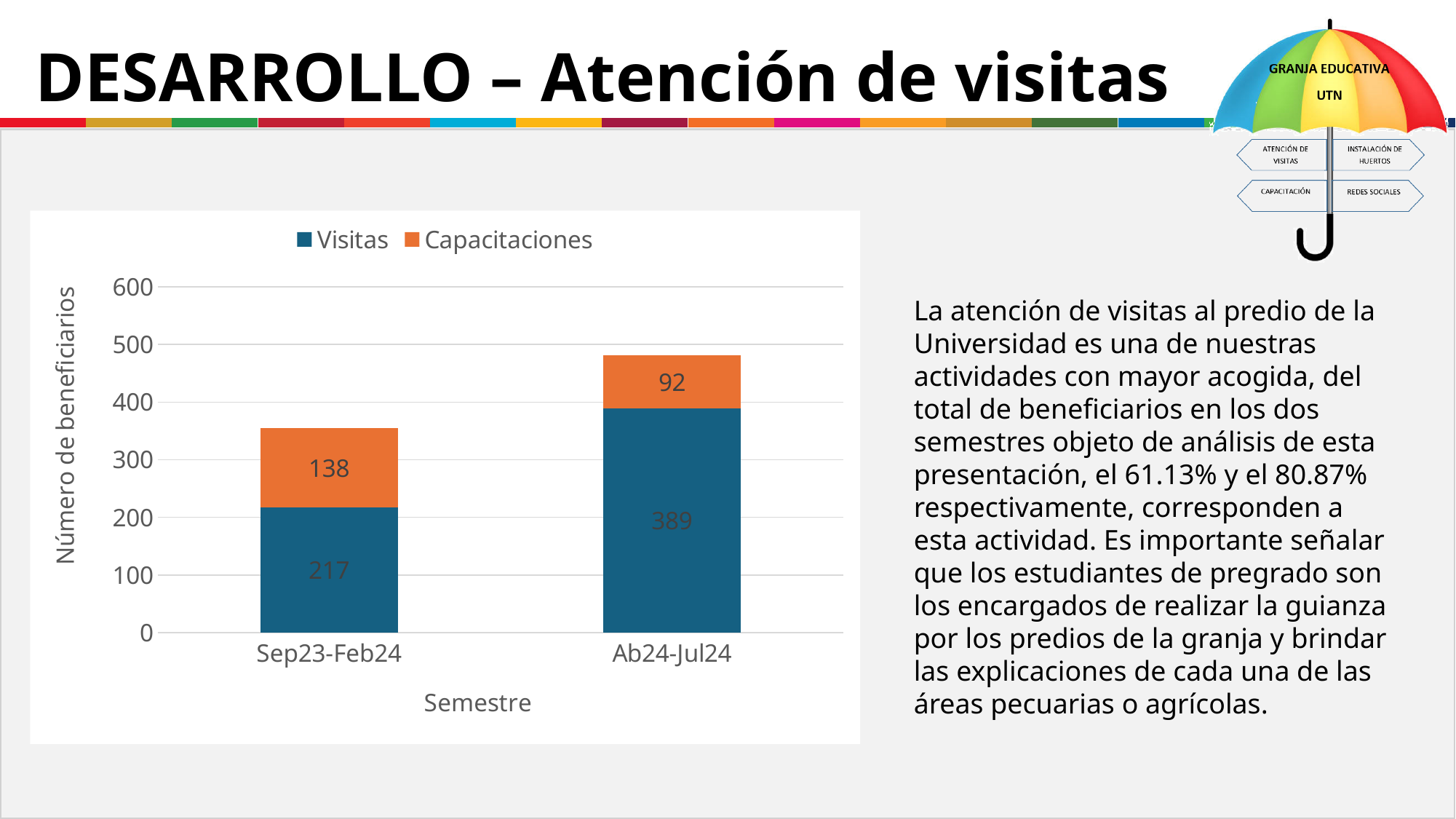
Which semester has the lower value for Capacitaciones? Ab24-Jul24 What is the value of Capacitaciones for Ab24-Jul24? 92 What is the total of the stacked bar for Sep23-Feb24? 355 What is the value of Capacitaciones for Sep23-Feb24? 138 What is the value of Visitas for Ab24-Jul24? 389 Which semester has the higher value for Visitas? Ab24-Jul24 What is the total of the stacked bar for Ab24-Jul24? 481 What is the difference between Visitas in Ab24-Jul24 and Visitas in Sep23-Feb24? 172 What kind of chart is shown on the slide? Stacked bar chart How many series does the legend list? 2 Is Capacitaciones for Sep23-Feb24 larger or smaller than Capacitaciones for Ab24-Jul24? larger What is the value of Visitas for Sep23-Feb24? 217